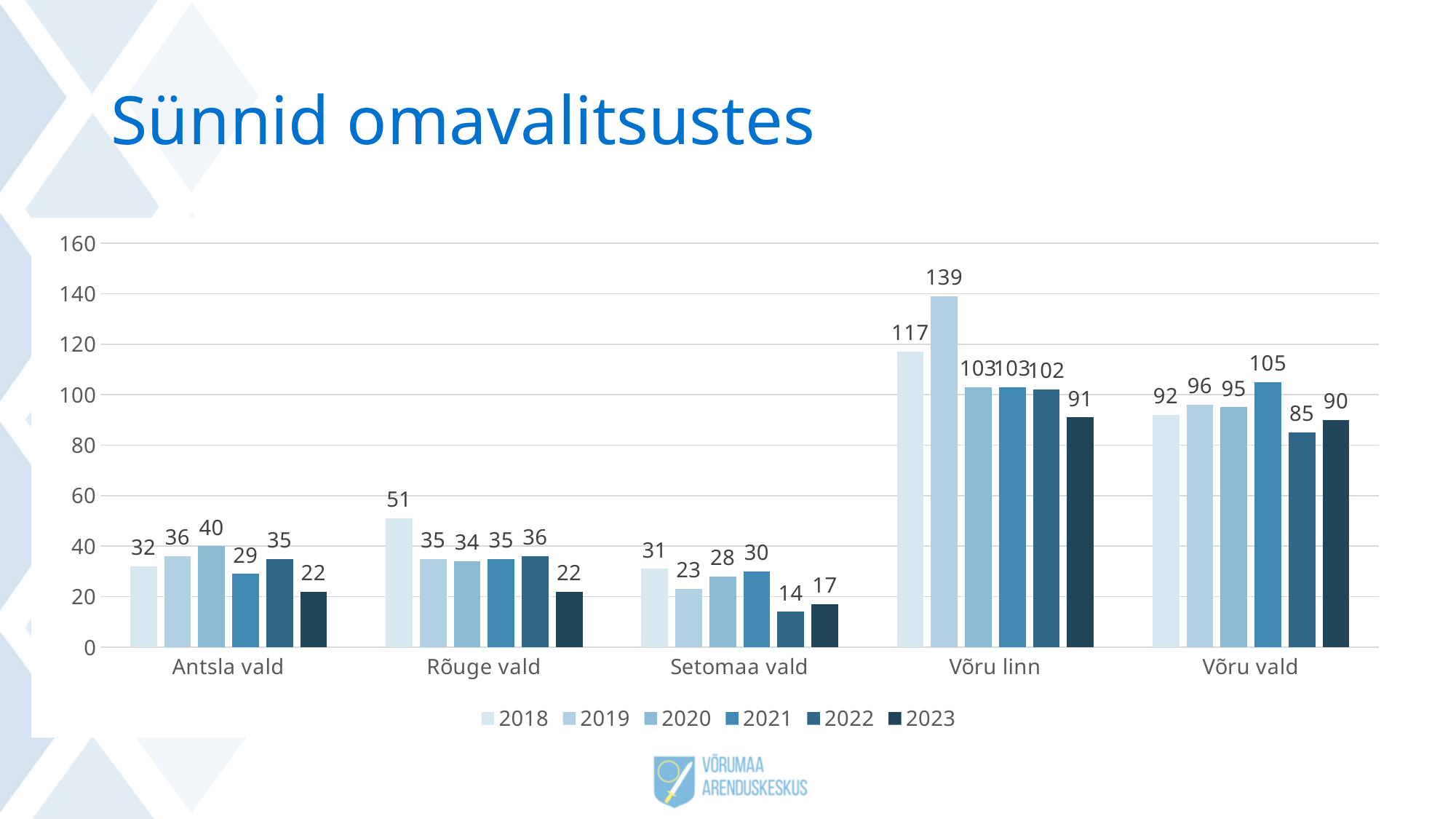
Which category has the lowest value in 2022? Setomaa vald What is the title of the slide? Sünnid omavalitsustes Which category has the highest value in 2023? Võru linn Is the value for Võru linn in 2018 greater or less than 100? greater What is the value for Rõuge vald in 2018? 51 Which is larger, the 2021 value for Võru vald or the 2021 value for Võru linn? Võru vald How many categories are shown on the x axis? 5 What is the value for Võru linn in 2019? 139 What kind of chart is shown on the slide? bar chart What is the difference between the 2019 and 2023 values for Võru linn? 48 What is the value for Setomaa vald in 2022? 14 How many series does the legend list? 6